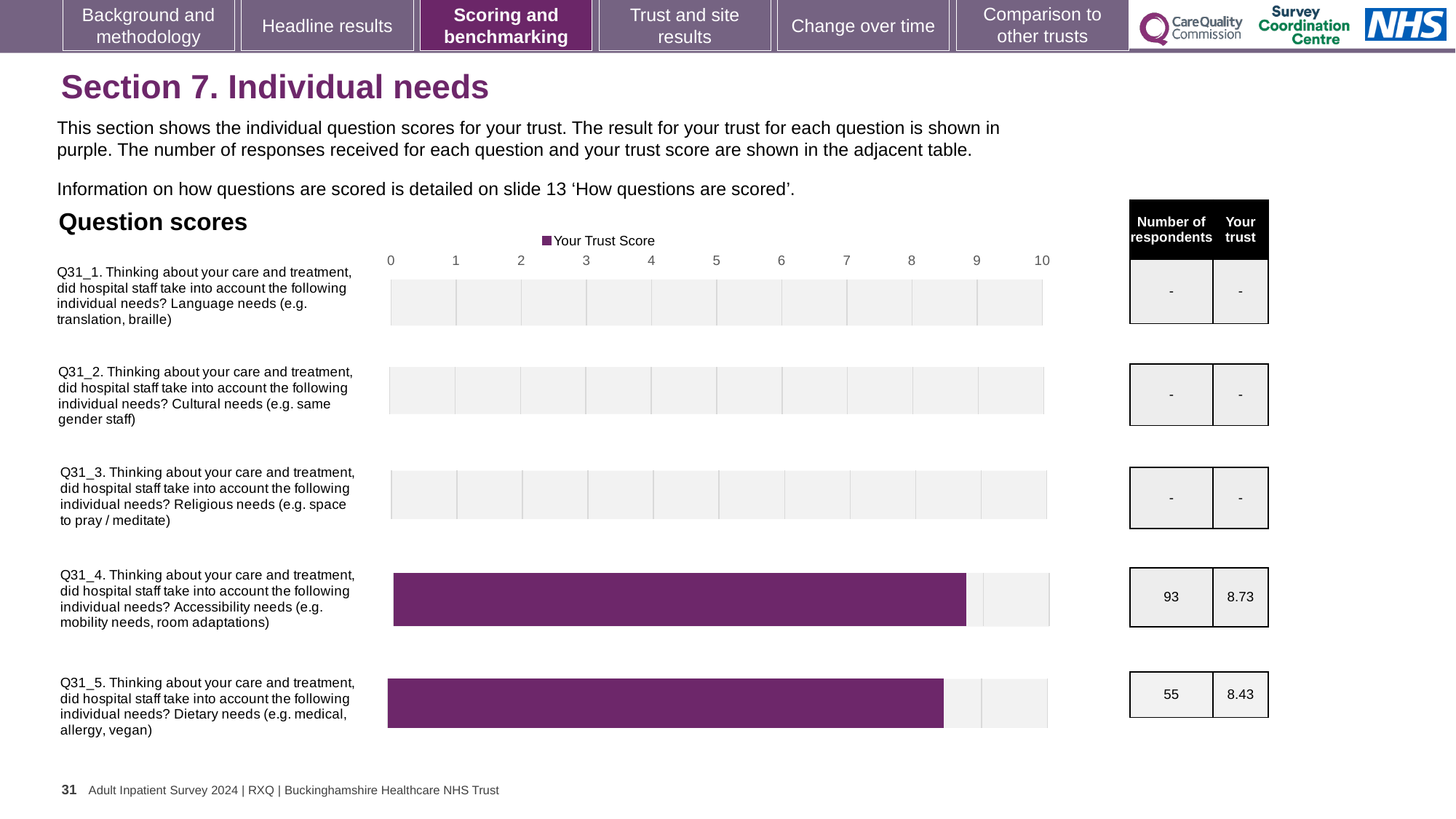
How many respondents answered Q31_4 (Accessibility needs)? 93 Which has a higher trust score, Q31_4 (Accessibility needs) or Q31_5 (Dietary needs)? Q31_4 (Accessibility needs) What is the name of the series shown in the chart legend? Your Trust Score How many questions are listed on the chart? 5 Which question has the highest trust score shown on the chart? Q31_4 (Accessibility needs) Is the trust score for Q31_5 (Dietary needs) greater or less than 9? less What kind of chart is shown on the slide? Bar chart What is the trust score for Q31_5 (Dietary needs)? 8.43 How many series does the chart legend list? 1 What is the trust score for Q31_4 (Accessibility needs)? 8.73 How many respondents answered Q31_5 (Dietary needs)? 55 What is the difference between the trust scores for Q31_4 and Q31_5? 0.30